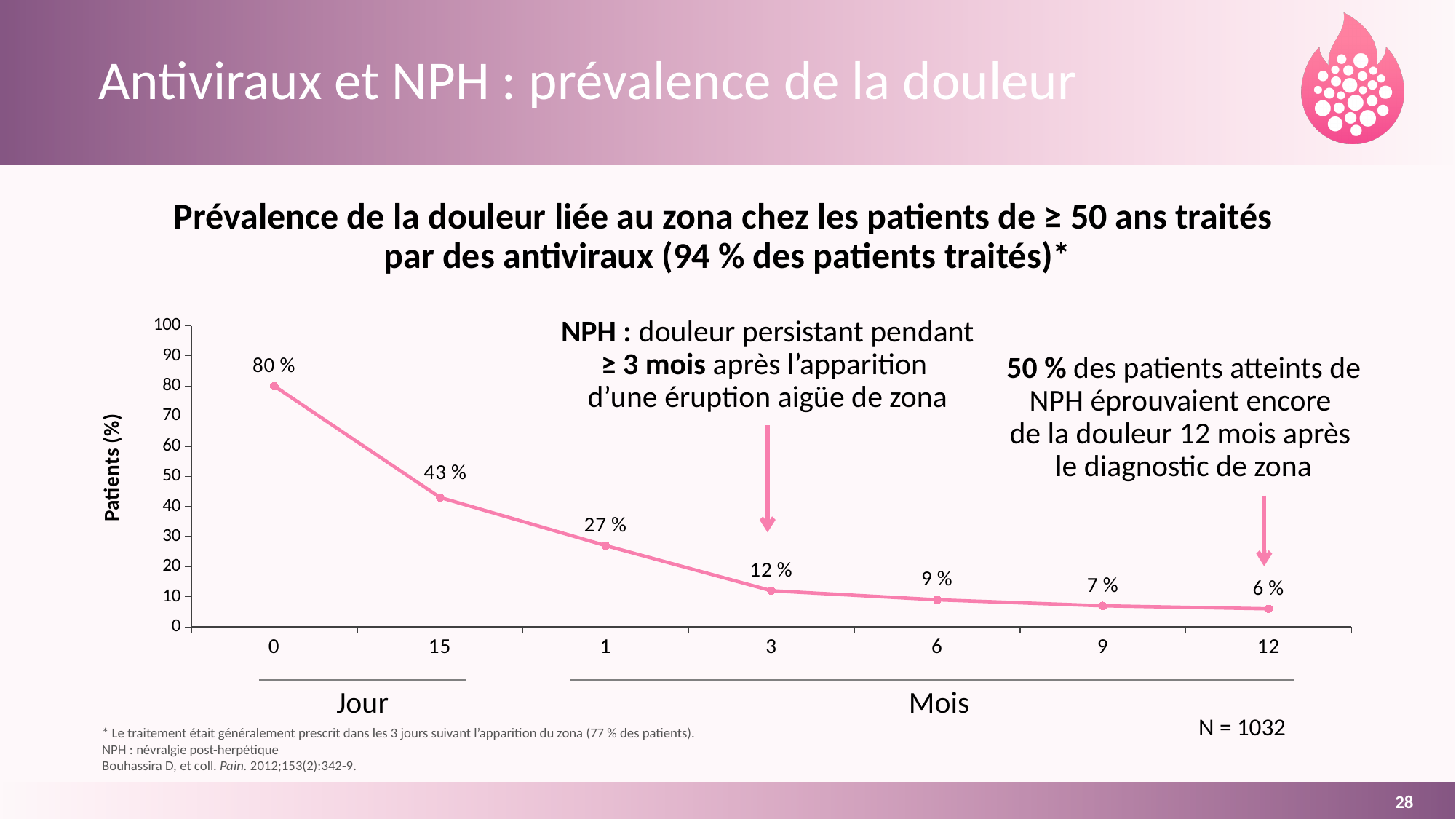
What is the difference between the value at day 0 and the value at day 15? 37 % Which is larger, the value at 6 months or the value at 9 months? 6 months (9 %) What percentage of patients had pain at day 0? 80 % At which time point is the prevalence of pain lowest? 12 (Mois) What is the value plotted at 3 months? 12 % What is the label of the y axis? Patients (%) What is the difference between the value at 1 month and the value at 3 months? 15 % At which time point is the prevalence of pain highest? 0 (Jour) Do the values rise or fall along the x axis? Fall How many data points are plotted on the line? 7 What kind of chart is shown on the slide? Line chart What percentage of patients still had pain at 12 months? 6 %